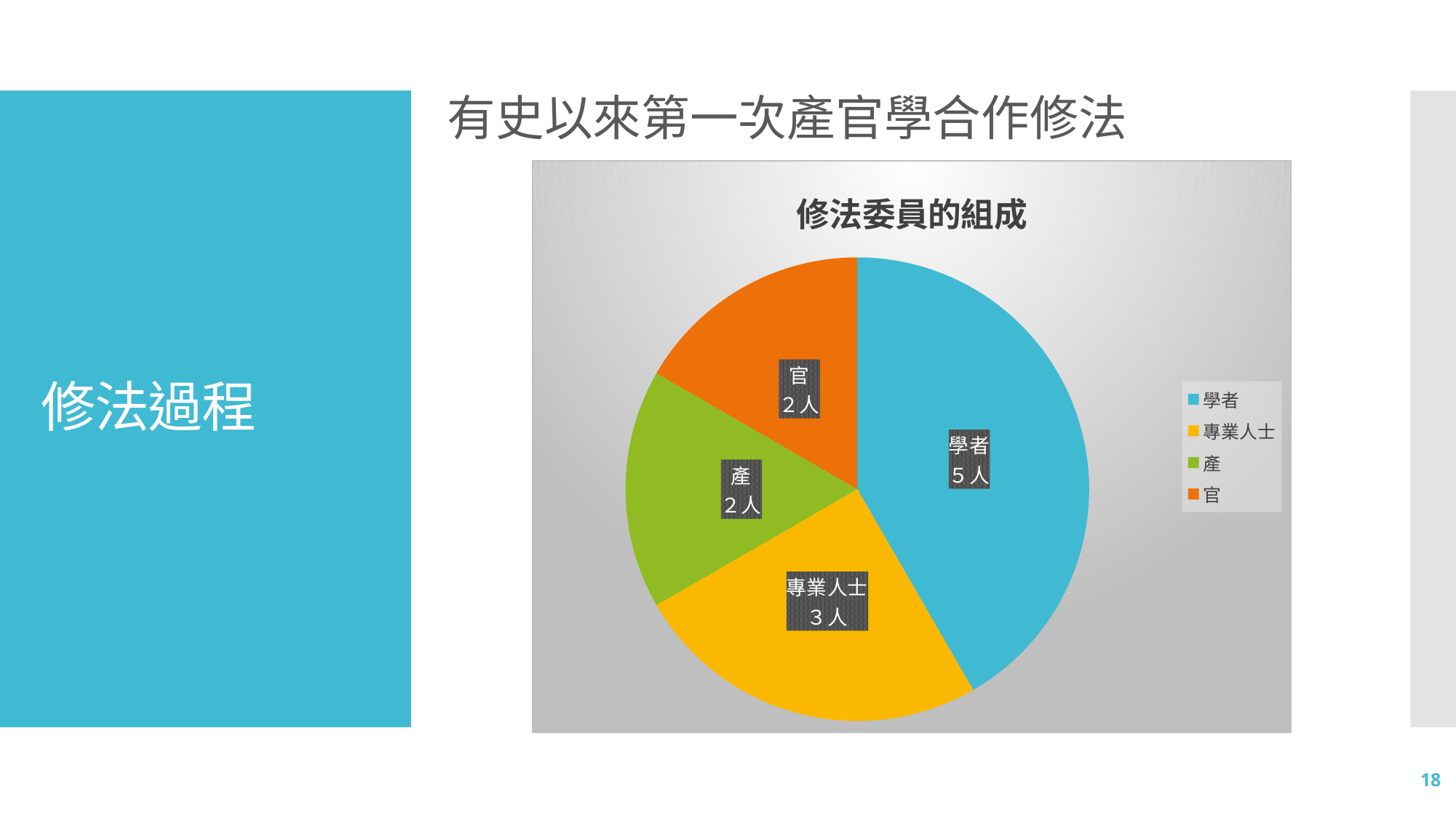
How many people are in the 專業人士 slice? 3 人 How many people are in the 官 slice? 2 人 Which category has the largest slice of the pie? 學者 How many slices does the pie chart have? 4 Which is larger, the 學者 slice or the 專業人士 slice? 學者 What is the total number of people across all slices of the pie? 12 人 How many entries does the legend list? 4 What is the title of the chart? 修法委員的組成 How many people are in the 產 slice? 2 人 How many people are in the 學者 slice? 5 人 What kind of chart is shown on the slide? pie chart What is the difference between the number of 學者 and the number of 專業人士? 2 人